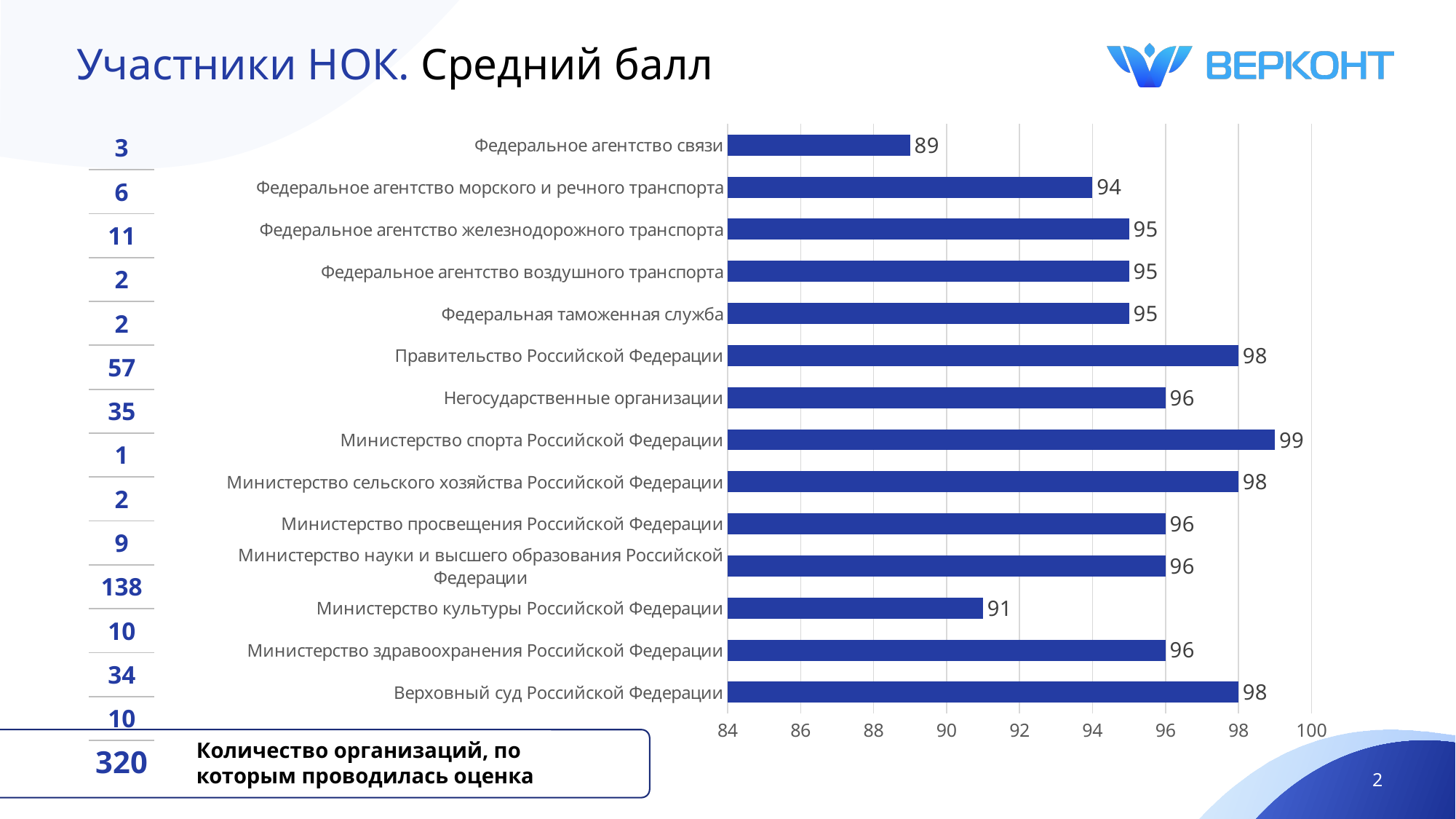
What is the difference between the values for Министерство спорта Российской Федерации and Федеральное агентство связи? 10 What is the value for Федеральное агентство морского и речного транспорта? 94 What kind of chart is shown on the slide? bar chart What is the title of the slide containing the chart? Участники НОК. Средний балл What is the value for Правительство Российской Федерации? 98 How many categories (organisations) are plotted in the chart? 14 Which category has the highest value in the chart? Министерство спорта Российской Федерации Which category has the lowest value in the chart? Федеральное агентство связи Is the value for Федеральное агентство связи greater or less than 90? less Which is larger: the value for Министерство культуры Российской Федерации or the value for Федеральное агентство морского и речного транспорта? Федеральное агентство морского и речного транспорта What is the value for Министерство культуры Российской Федерации? 91 What is the value for Федеральное агентство связи? 89